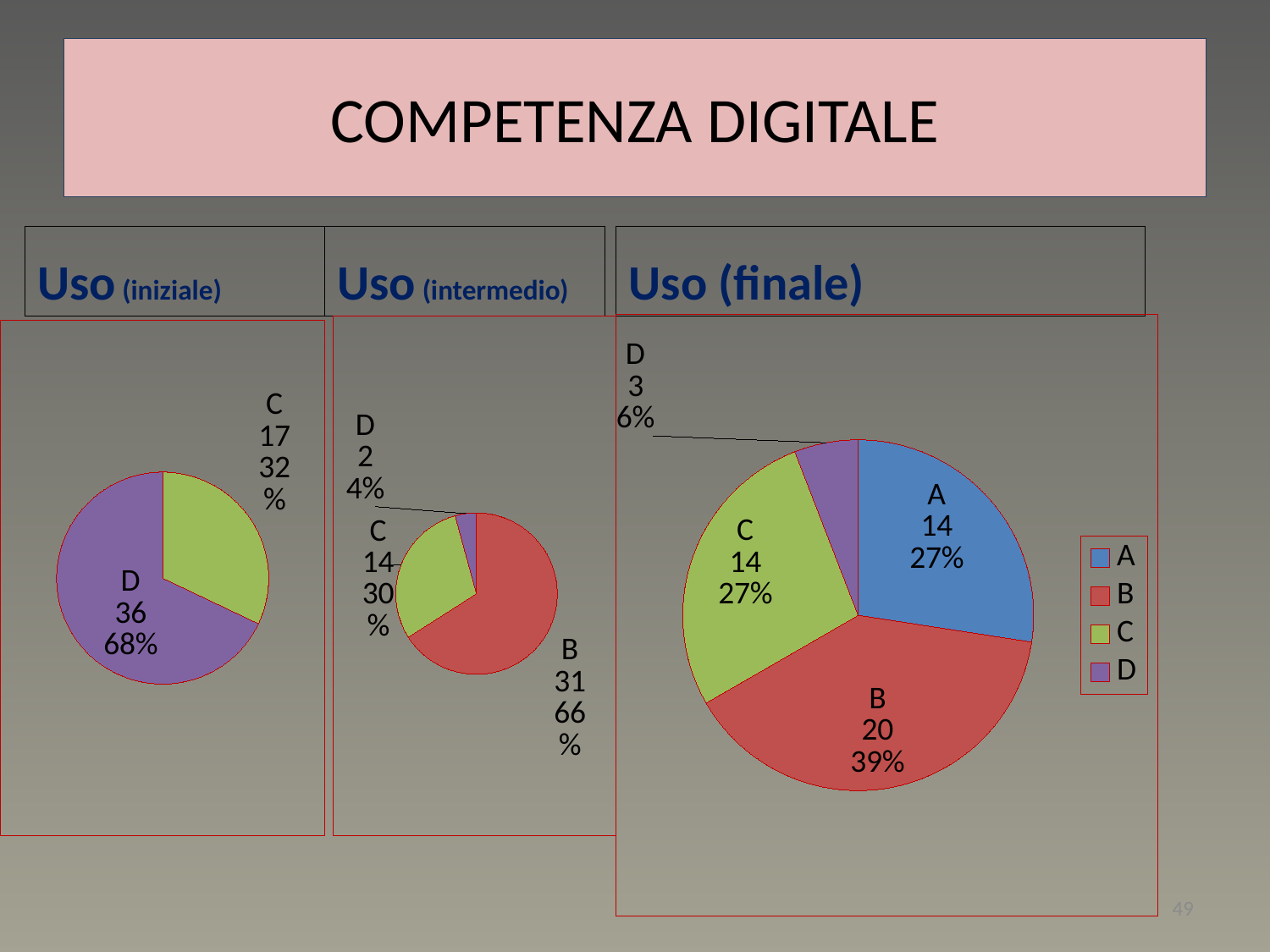
In the Uso (iniziale) pie chart, what is the value for D? 36 In the Uso (iniziale) pie chart, how many slices are there? 2 In the Uso (iniziale) pie chart, what share of the pie does C represent? 32% What kind of chart is used for Uso (finale)? Pie chart In the Uso (finale) pie chart, which category has the largest slice? B In the Uso (intermedio) pie chart, which category has the smallest slice? D In the Uso (finale) pie chart, how many entries does the legend list? 4 In the Uso (intermedio) pie chart, what share of the pie does C represent? 30% In the Uso (intermedio) pie chart, what is the difference between the values for B and C? 17 In the Uso (finale) pie chart, what share of the pie does D represent? 6% In the Uso (intermedio) pie chart, what is the value for B? 31 In the Uso (finale) pie chart, what is the value for B? 20